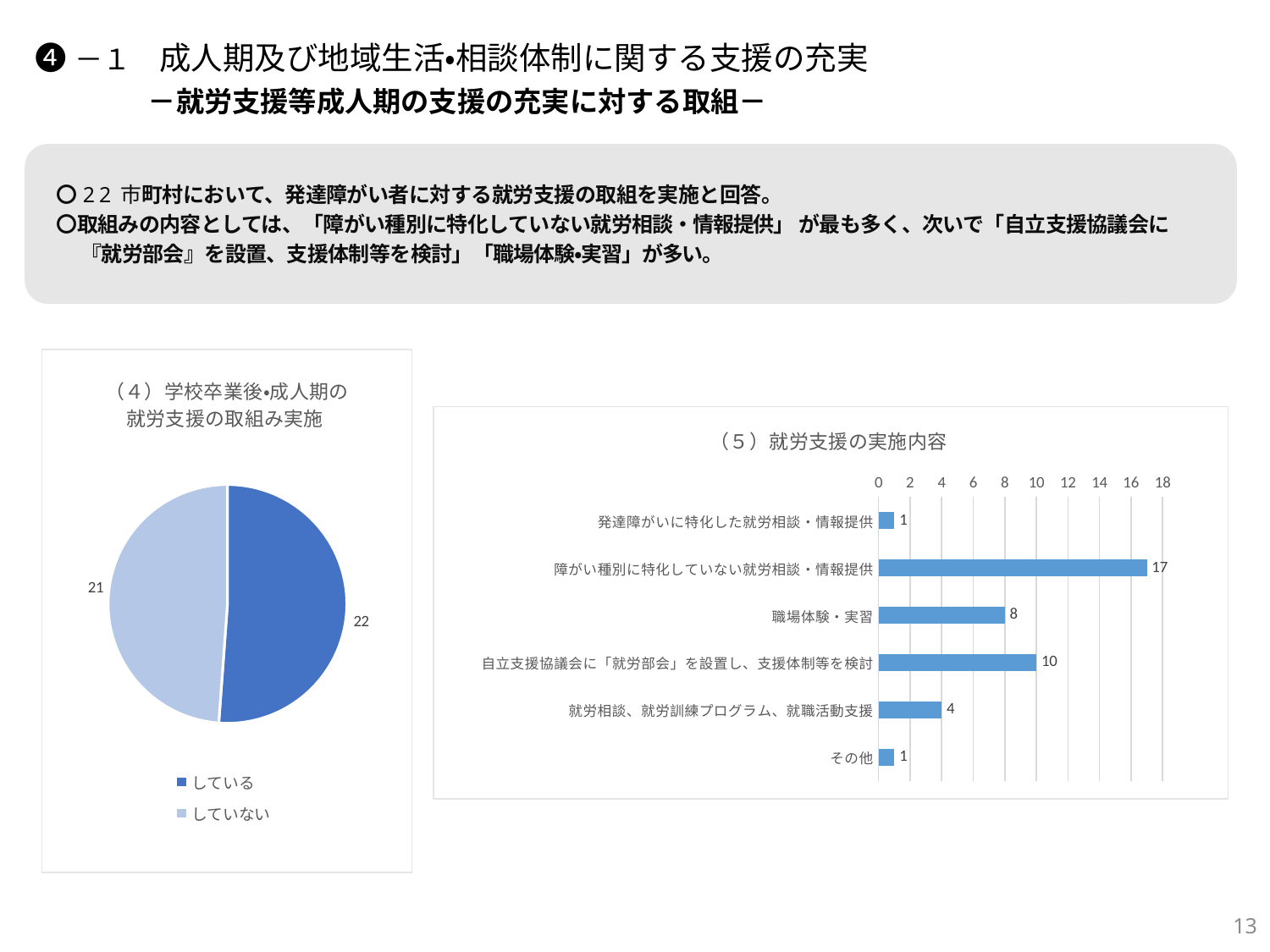
In the pie chart titled (4) 学校卒業後・成人期の就労支援の取組み実施, what is the value for していない? 21 In the bar chart titled (5) 就労支援の実施内容, how many categories are shown? 6 In the bar chart titled (5) 就労支援の実施内容, what kind of chart is shown? Bar chart In the bar chart titled (5) 就労支援の実施内容, what is the value for 障がい種別に特化していない就労相談・情報提供? 17 In the bar chart titled (5) 就労支援の実施内容, which is larger: 職場体験・実習 or 就労相談、就労訓練プログラム、就職活動支援? 職場体験・実習 In the pie chart titled (4) 学校卒業後・成人期の就労支援の取組み実施, what is the value for している? 22 In the bar chart titled (5) 就労支援の実施内容, what is the difference between the values for 障がい種別に特化していない就労相談・情報提供 and 職場体験・実習? 9 In the bar chart titled (5) 就労支援の実施内容, which category has the highest value? 障がい種別に特化していない就労相談・情報提供 In the pie chart on the left, how many entries does the legend list? 2 In the bar chart titled (5) 就労支援の実施内容, what is the value for その他? 1 In the bar chart titled (5) 就労支援の実施内容, what is the value for 自立支援協議会に「就労部会」を設置し、支援体制等を検討? 10 In the pie chart on the left, what kind of chart is shown? Pie chart